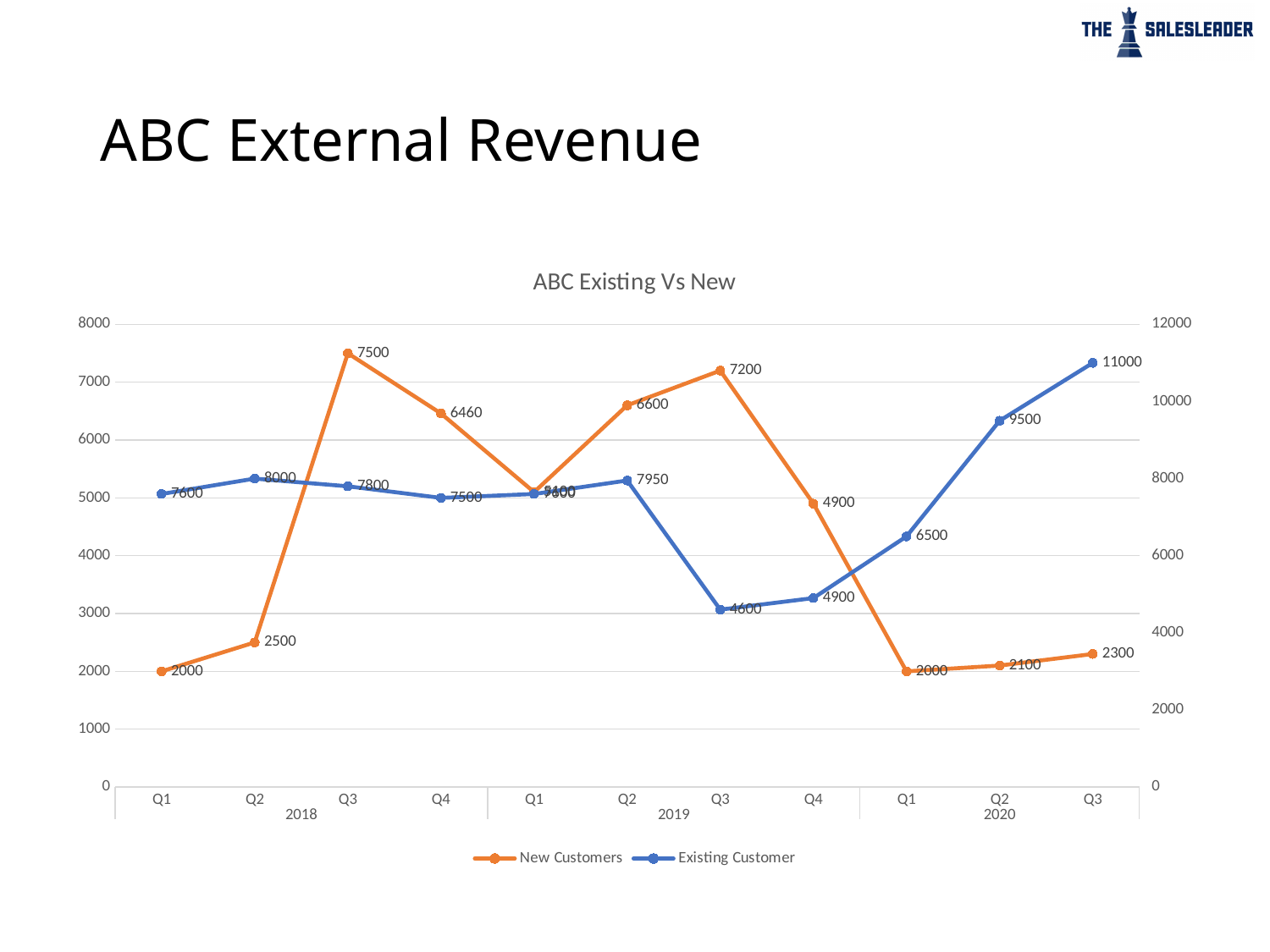
What is the Existing Customer value for Q3 2020? 11000 What is the New Customers value for Q4 2019? 4900 What is the New Customers value for Q3 2018? 7500 Does the Existing Customer line rise or fall from Q3 2019 to Q3 2020? rise What kind of chart is shown on the slide? line chart In which quarter is the New Customers value highest? Q3 2018 How many quarters are plotted along the x axis? 11 What is the difference between the New Customers values for Q3 2018 and Q4 2018? 1040 In which quarter is the Existing Customer value lowest? Q3 2019 How many series does the legend list? 2 What is the title of the chart? ABC Existing Vs New Which quarter has the larger Existing Customer value, Q1 2020 or Q2 2020? Q2 2020